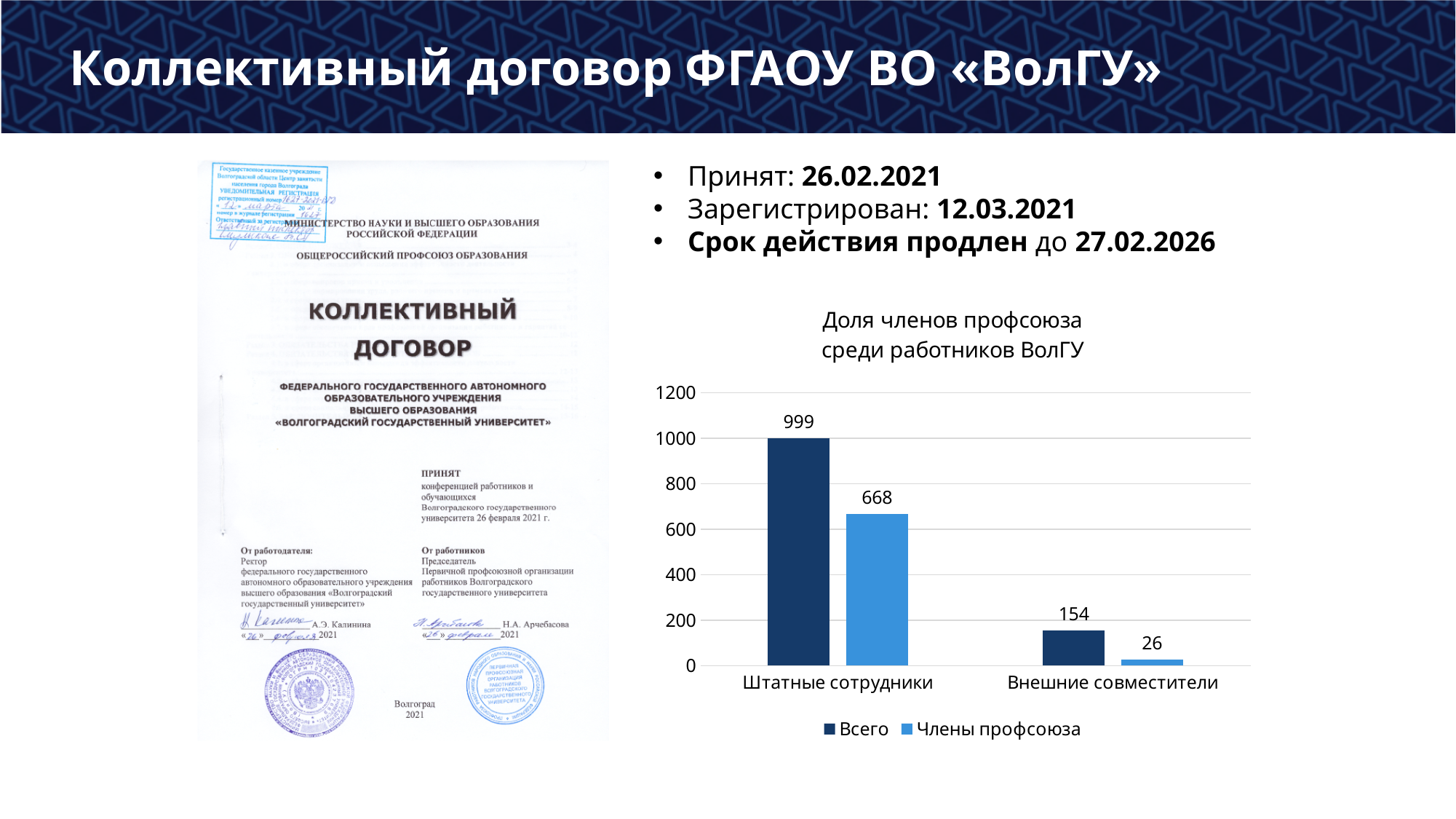
What is the value for 'Члены профсоюза' in the 'Штатные сотрудники' category? 668 How many categories are shown on the x axis of the chart? 2 What is the value for 'Всего' in the 'Внешние совместители' category? 154 What is the value for 'Члены профсоюза' in the 'Внешние совместители' category? 26 How many series does the chart legend list? 2 What kind of chart is shown on the slide? Bar chart Which is larger: 'Члены профсоюза' for 'Штатные сотрудники' or 'Всего' for 'Внешние совместители'? Члены профсоюза for Штатные сотрудники Which category has the lowest 'Члены профсоюза' value? Внешние совместители What is the value for 'Всего' in the 'Штатные сотрудники' category? 999 What is the difference between 'Всего' and 'Члены профсоюза' for 'Внешние совместители'? 128 What is the difference between 'Всего' and 'Члены профсоюза' for 'Штатные сотрудники'? 331 Which category has the highest 'Всего' value? Штатные сотрудники